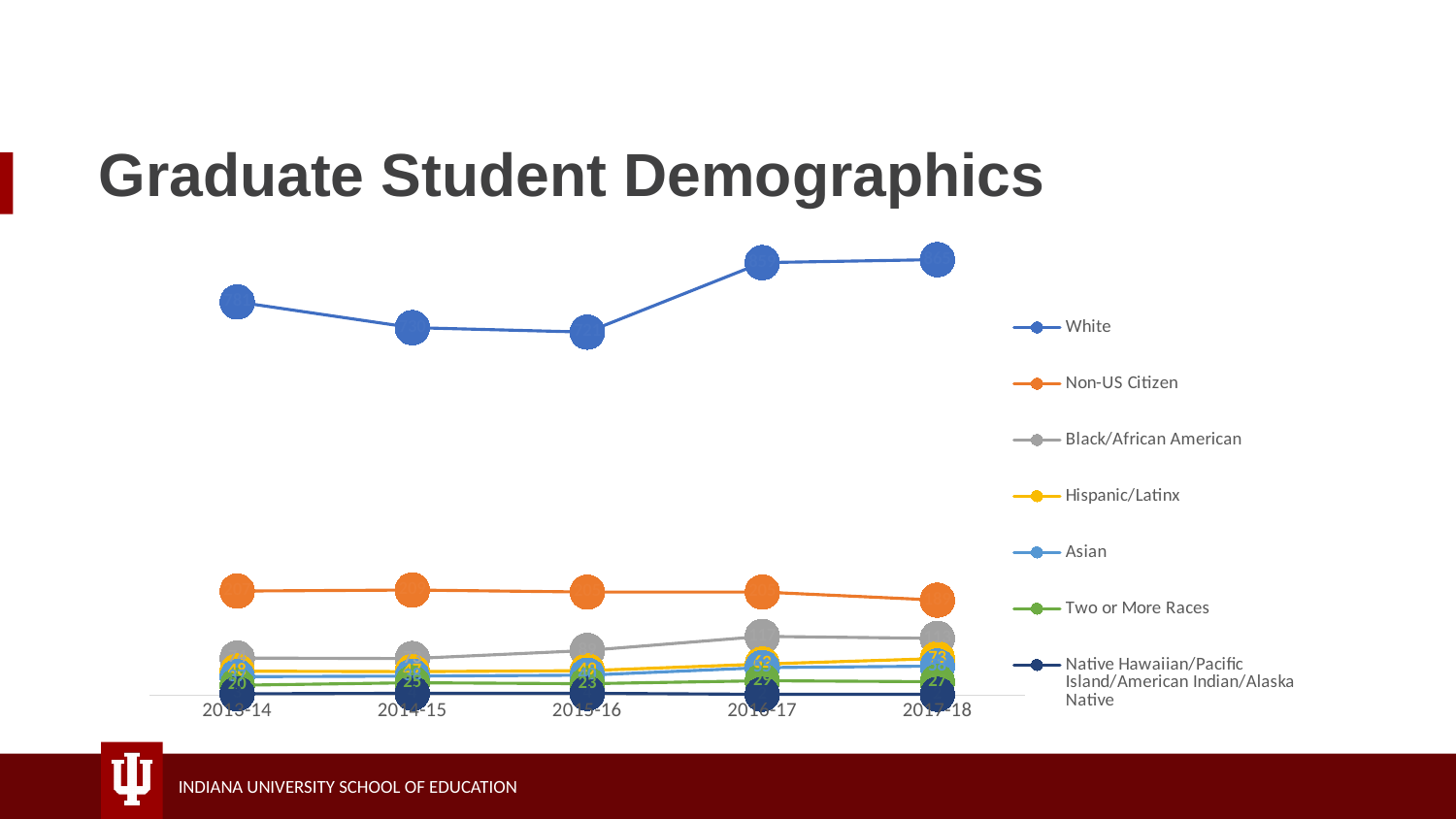
How many academic years are shown along the x axis? 5 What kind of chart is shown on the slide? Line chart Which series has the lowest values across all years? Native Hawaiian/Pacific Island/American Indian/Alaska Native In 2016-17, which is larger: the value for Non-US Citizen or the value for Black/African American? Non-US Citizen How many series does the legend list? 7 For the White series, is the value in 2017-18 higher or lower than in 2013-14? Higher In 2017-18, which is larger: the value for White or the value for Non-US Citizen? White What is the title of the chart? Graduate Student Demographics Which series has the highest values across all years? White Which series is the second highest in every year shown? Non-US Citizen For the White series, is the value in 2015-16 higher or lower than in 2013-14? Lower Which legend entry is shown in orange? Non-US Citizen